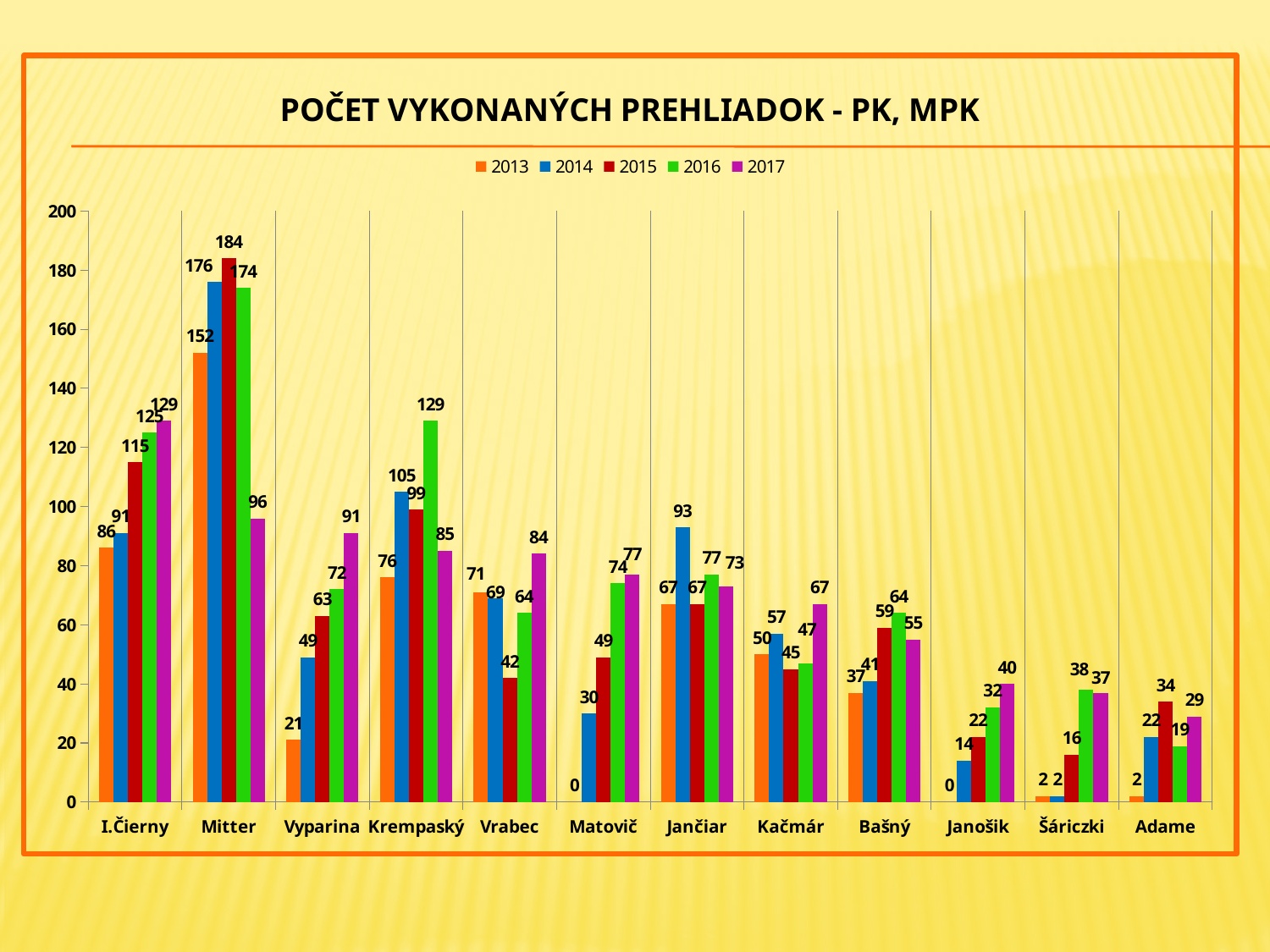
What is the difference between the 2017 and 2013 values for Vyparina? 70 What is the value for Mitter in the 2015 series? 184 What is the value for Vyparina in 2013? 21 What is the title of the chart? POČET VYKONANÝCH PREHLIADOK - PK, MPK Which category has the highest value in the 2014 series? Mitter Which is larger for Jančiar: the 2014 value or the 2016 value? 2014 What is the value for Krempaský in the 2016 series? 129 How many categories are shown on the x axis? 12 How many series does the legend list? 5 What kind of chart is shown on the slide? bar chart Do the values for Janošik rise or fall from 2013 to 2017? rise Which category has the lowest value in the 2017 series? Adame